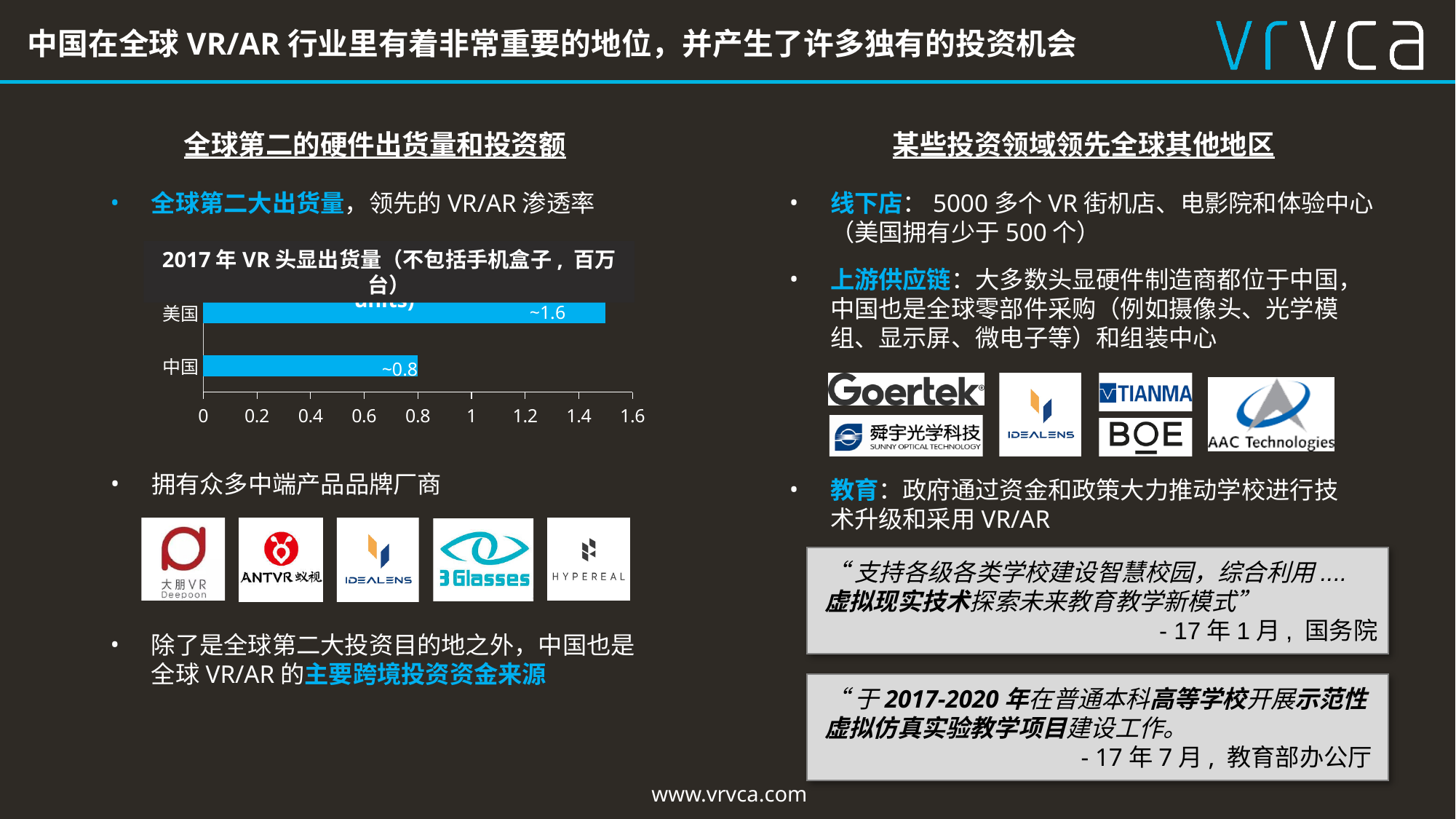
Which category has the lowest value in the chart? 中国 Is the value for 美国 greater or less than 1.4? greater What kind of chart is shown on the slide? bar chart What is the maximum value shown on the chart's horizontal axis? 1.6 What is the title of the chart? 2017 年 VR 头显出货量（不包括手机盒子，百万台） Which category has the highest value in the chart? 美国 Which has the larger value, 美国 or 中国? 美国 Is the value for 美国 greater or less than 1? greater How many categories does the chart show? 2 Is the value for 中国 greater or less than 0.6? greater